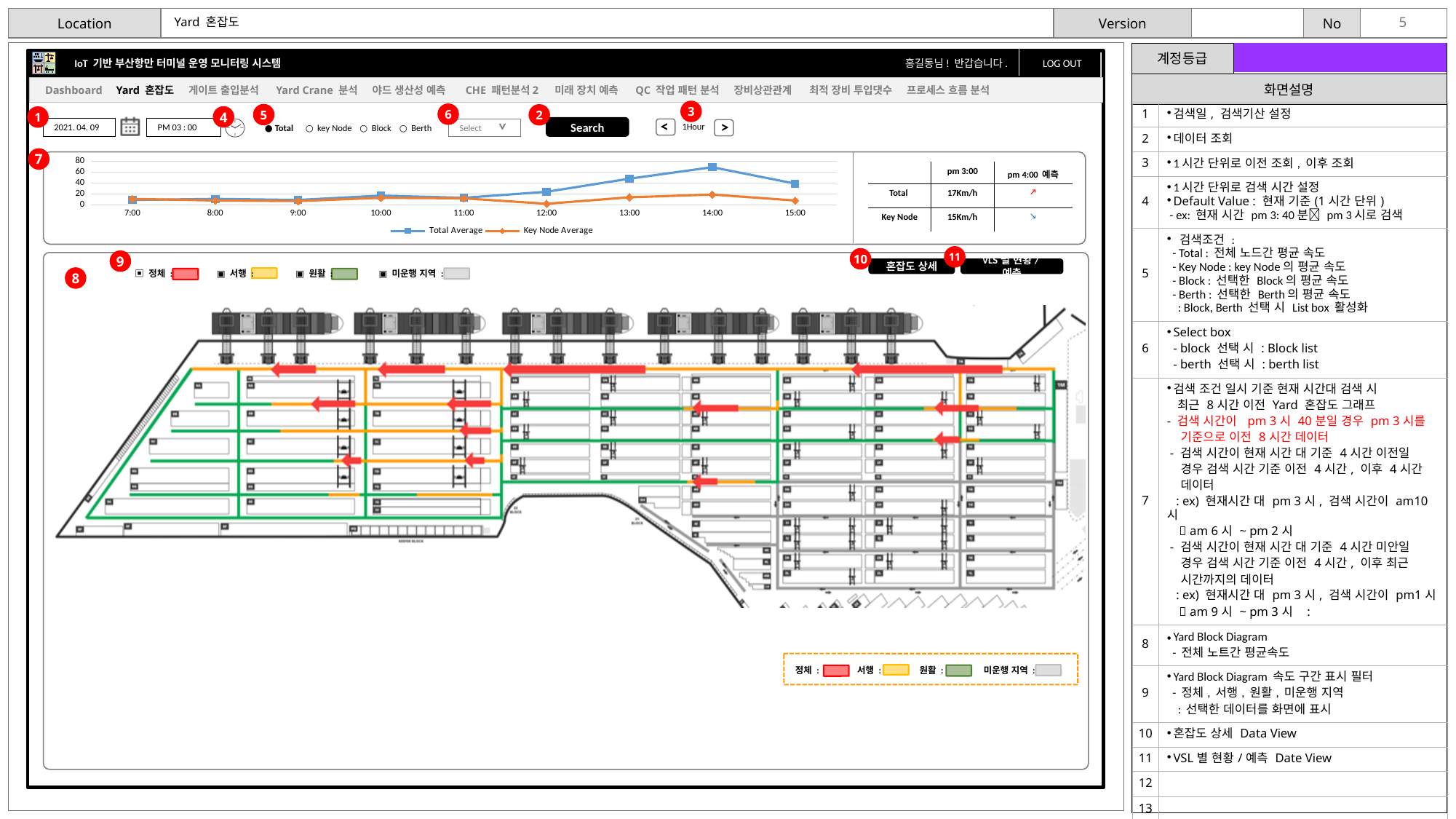
Does the Total Average series rise or fall between 12:00 and 14:00? rise Is the Total Average value at 7:00 greater or less than 20? less Is the Total Average value at 14:00 greater or less than 60? greater At which time does the Total Average series reach its highest value? 14:00 What kind of chart is shown at the top of the screen mockup? line chart How many time points are plotted along the x axis of the line chart? 9 At 12:00, which series has the larger value, Total Average or Key Node Average? Total Average How many series does the legend of the line chart list? 2 Does the Total Average series rise or fall between 14:00 and 15:00? fall At 14:00, which series has the larger value, Total Average or Key Node Average? Total Average What are the two series named in the line chart's legend? Total Average and Key Node Average Is the Key Node Average value at 14:00 greater or less than 40? less